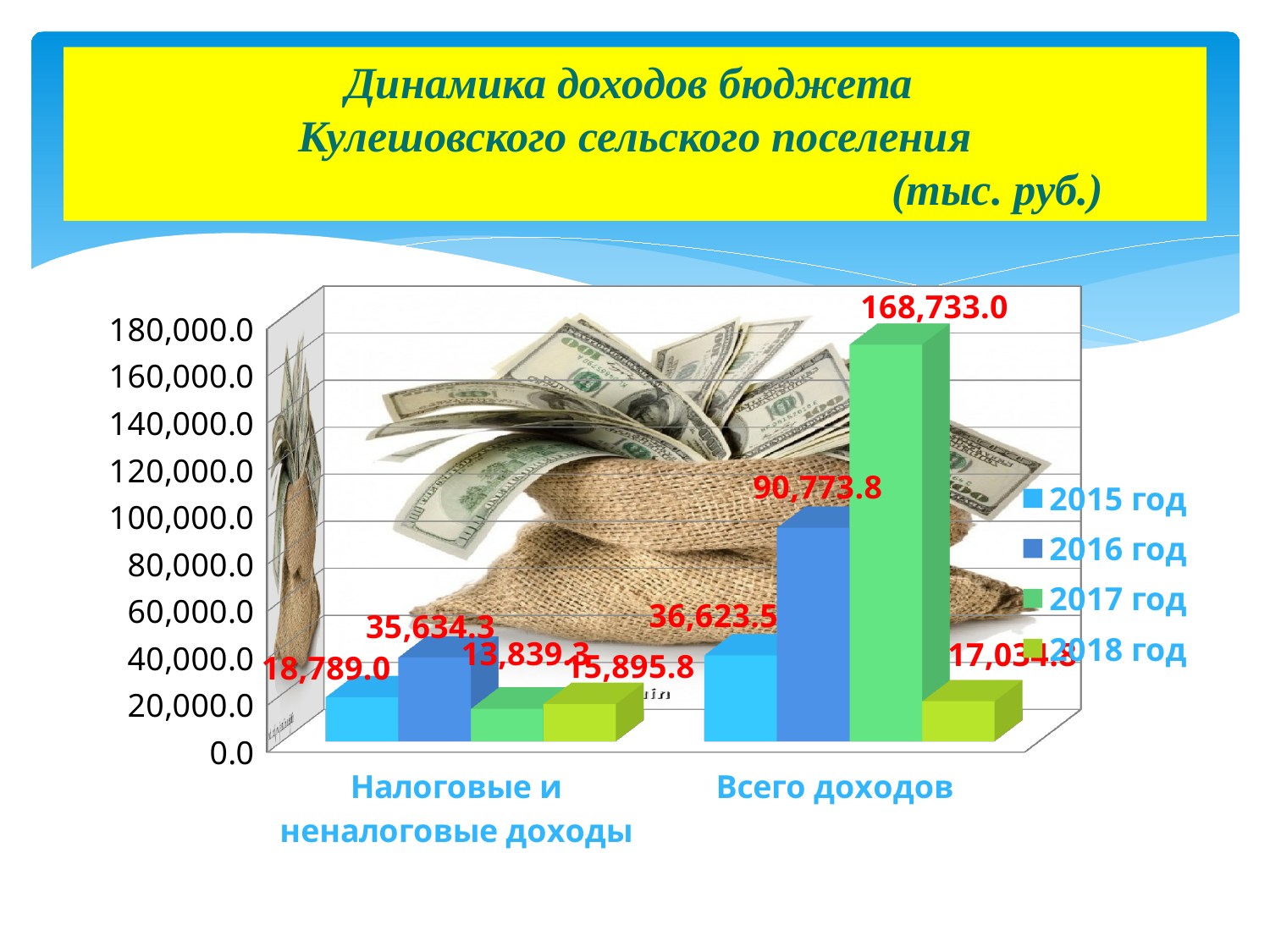
What is the value for 2017 год in the category Налоговые и неналоговые доходы? 13,839.3 How many categories are shown on the x axis? 2 Which year has the highest value in the category Всего доходов? 2017 год How many series does the legend list? 4 What kind of chart is shown on the slide? bar chart What is the value for 2015 год in the category Налоговые и неналоговые доходы? 18,789.0 What is the difference between the 2017 год and 2016 год values in the category Всего доходов? 77,959.2 What is the value for 2018 год in the category Налоговые и неналоговые доходы? 15,895.8 What is the value for 2016 год in the category Налоговые и неналоговые доходы? 35,634.3 Which year has the lowest value in the category Налоговые и неналоговые доходы? 2017 год What is the value for 2016 год in the category Всего доходов? 90,773.8 What is the value for 2017 год in the category Всего доходов? 168,733.0